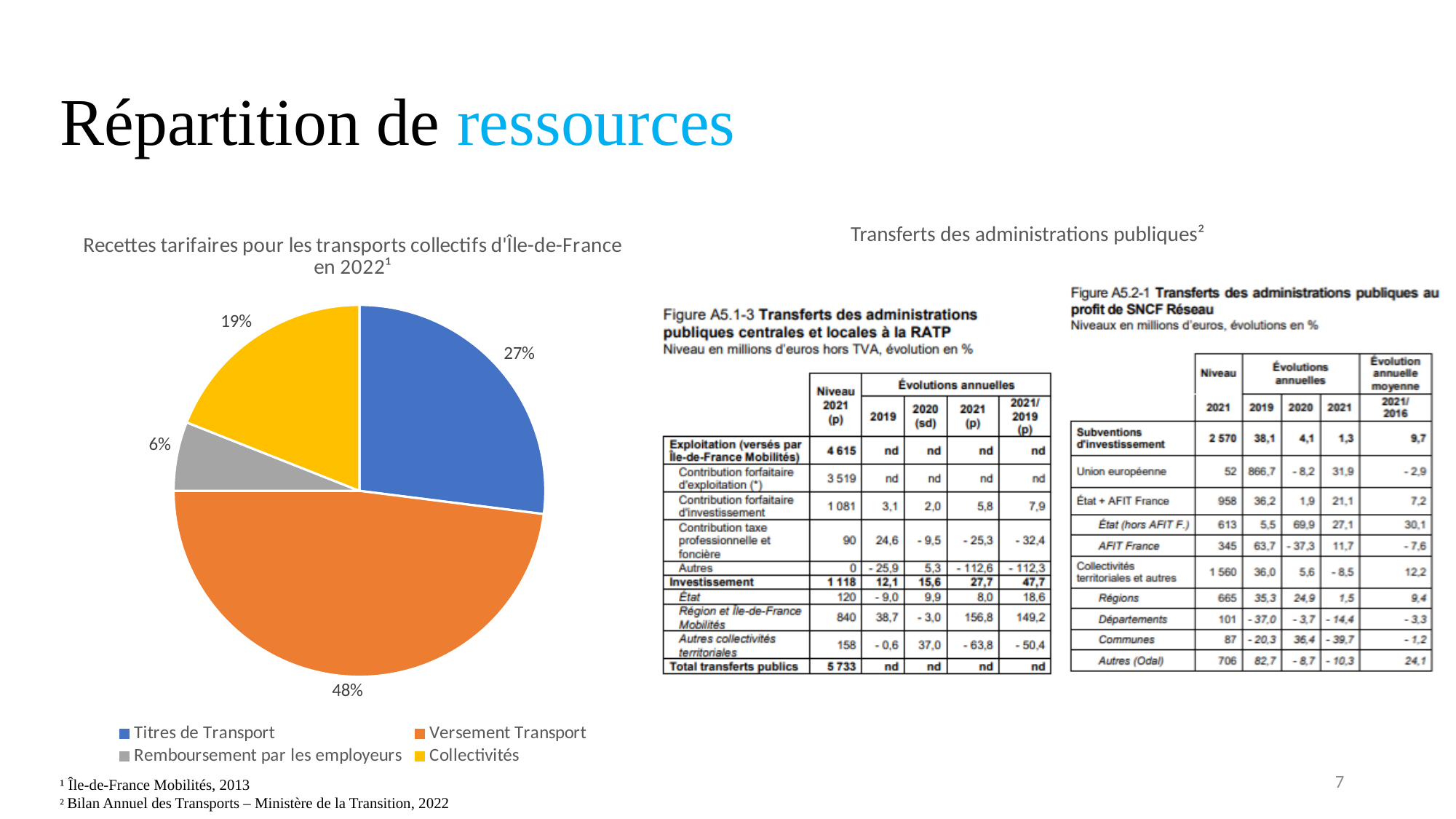
How many slices does the pie chart have? 4 In the pie chart, what share is shown for Versement Transport? 48% In the pie chart, what share is shown for Titres de Transport? 27% In the pie chart, what share is shown for Collectivités? 19% What kind of chart is 'Recettes tarifaires pour les transports collectifs d'Île-de-France en 2022'? Pie chart In the pie chart, what share is shown for Remboursement par les employeurs? 6% Which category has the largest slice in the pie chart? Versement Transport In the pie chart, which is larger: Collectivités or Titres de Transport? Titres de Transport What colour is the Collectivités slice in the pie chart? Yellow In the pie chart, what is the difference between the shares of Versement Transport and Titres de Transport? 21% Which category has the smallest slice in the pie chart? Remboursement par les employeurs How many entries does the pie chart's legend list? 4